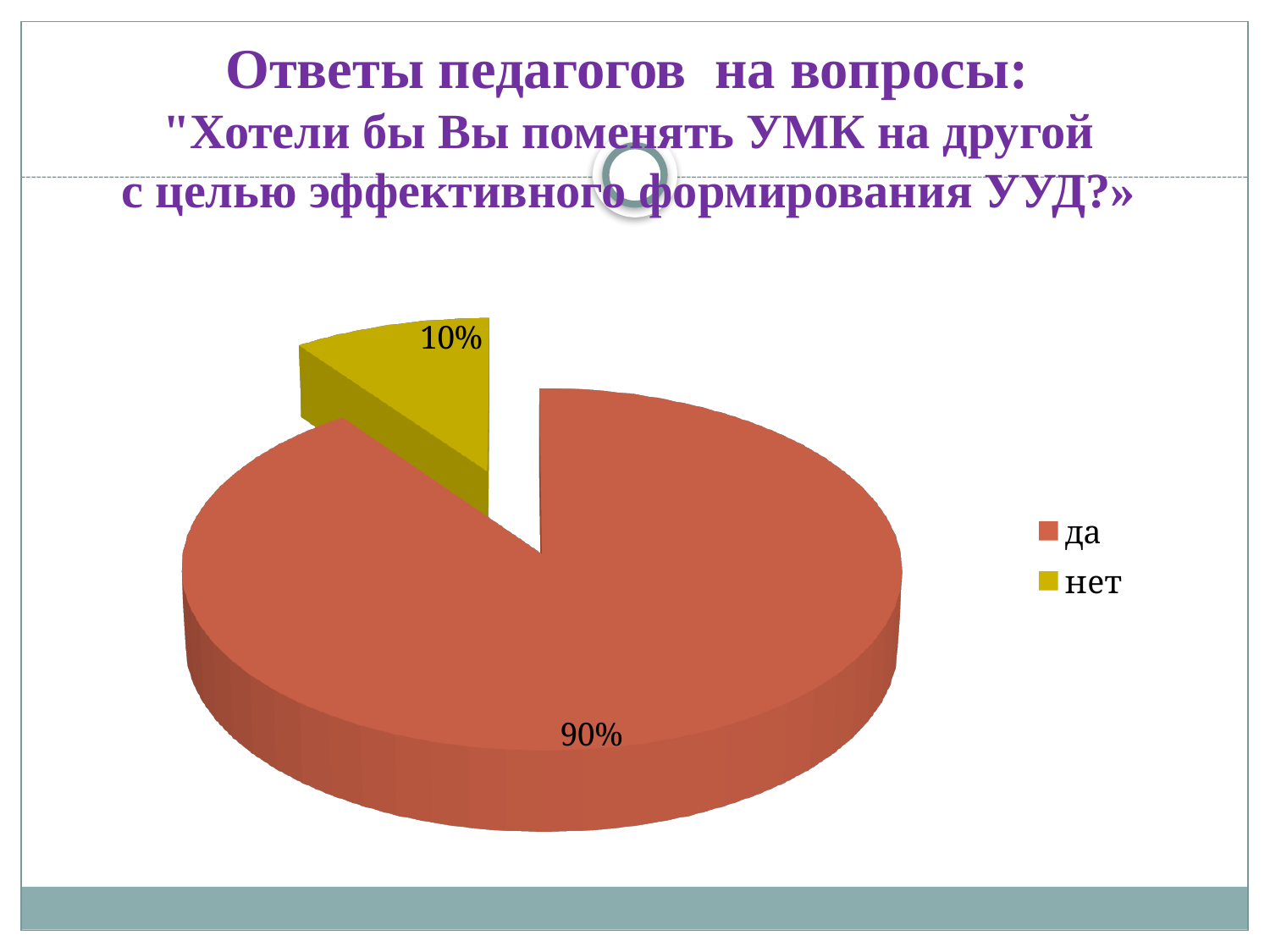
What share of the pie does the "да" slice represent? 90% What kind of chart is shown on the slide? pie chart How many entries does the legend list? 2 Which is larger, the "да" slice or the "нет" slice? да How many slices does the pie chart have? 2 Which category has the smallest slice of the pie? нет What is the difference in percentage points between the "да" and "нет" slices? 80 What colour is the "нет" slice? yellow What share of the pie does the "нет" slice represent? 10% What colour is the "да" slice? red Which category has the largest slice of the pie? да